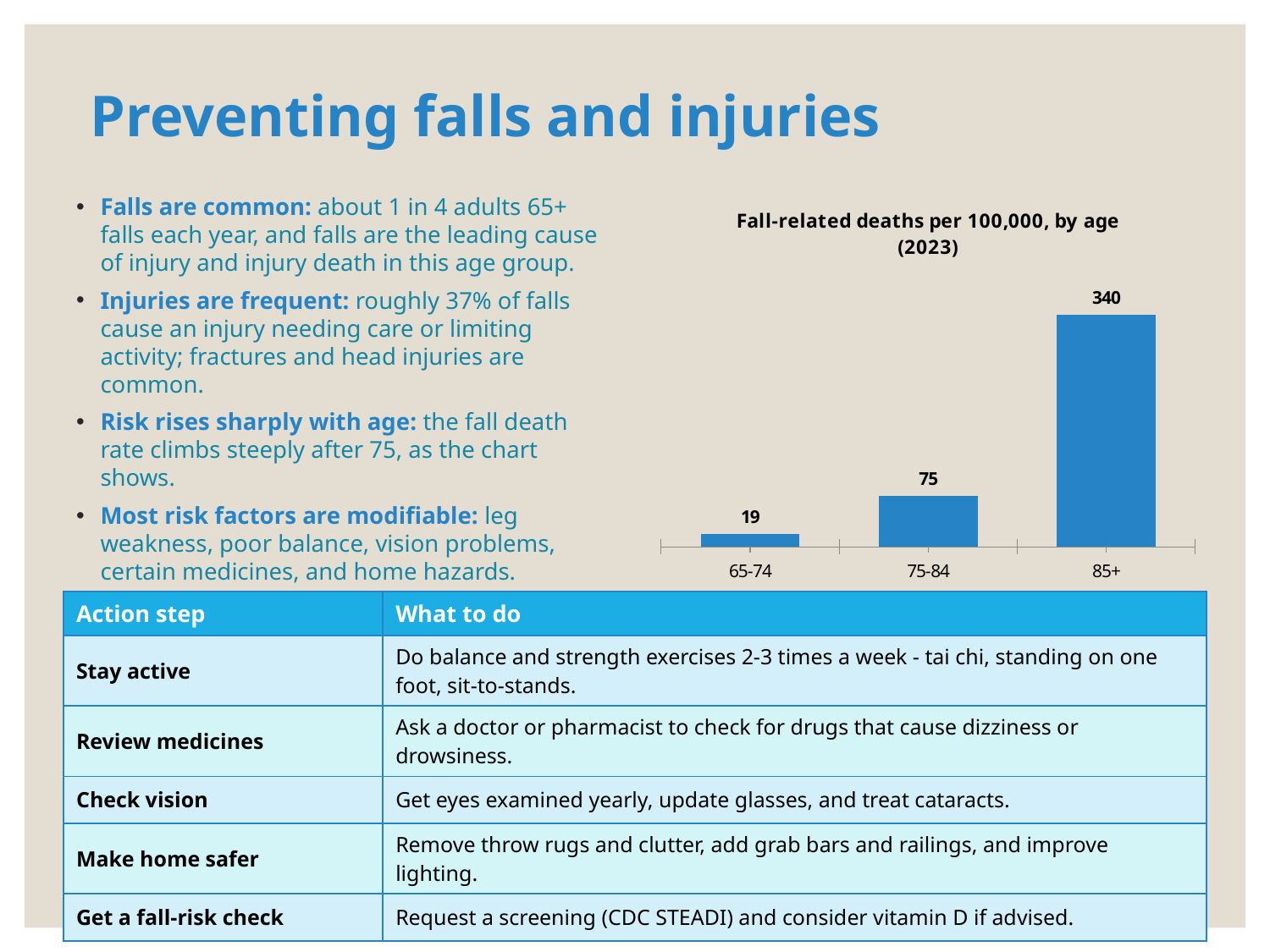
What is the title of the chart? Fall-related deaths per 100,000, by age (2023) How many age groups are shown in the chart? 3 What is the fall-related death rate per 100,000 for the 65-74 age group? 19 What is the fall-related death rate per 100,000 for the 85+ age group? 340 What kind of chart is used to show fall-related deaths by age? Bar chart What is the fall-related death rate per 100,000 for the 75-84 age group? 75 Which age group has the lowest fall-related death rate? 65-74 What is the difference between the fall-related death rates for the 75-84 and 65-74 age groups? 56 Do the fall-related death rates rise or fall as age increases along the x axis? Rise What is the difference between the fall-related death rates for the 85+ and 75-84 age groups? 265 Which age group has a higher fall-related death rate, 65-74 or 75-84? 75-84 Which age group has the highest fall-related death rate? 85+